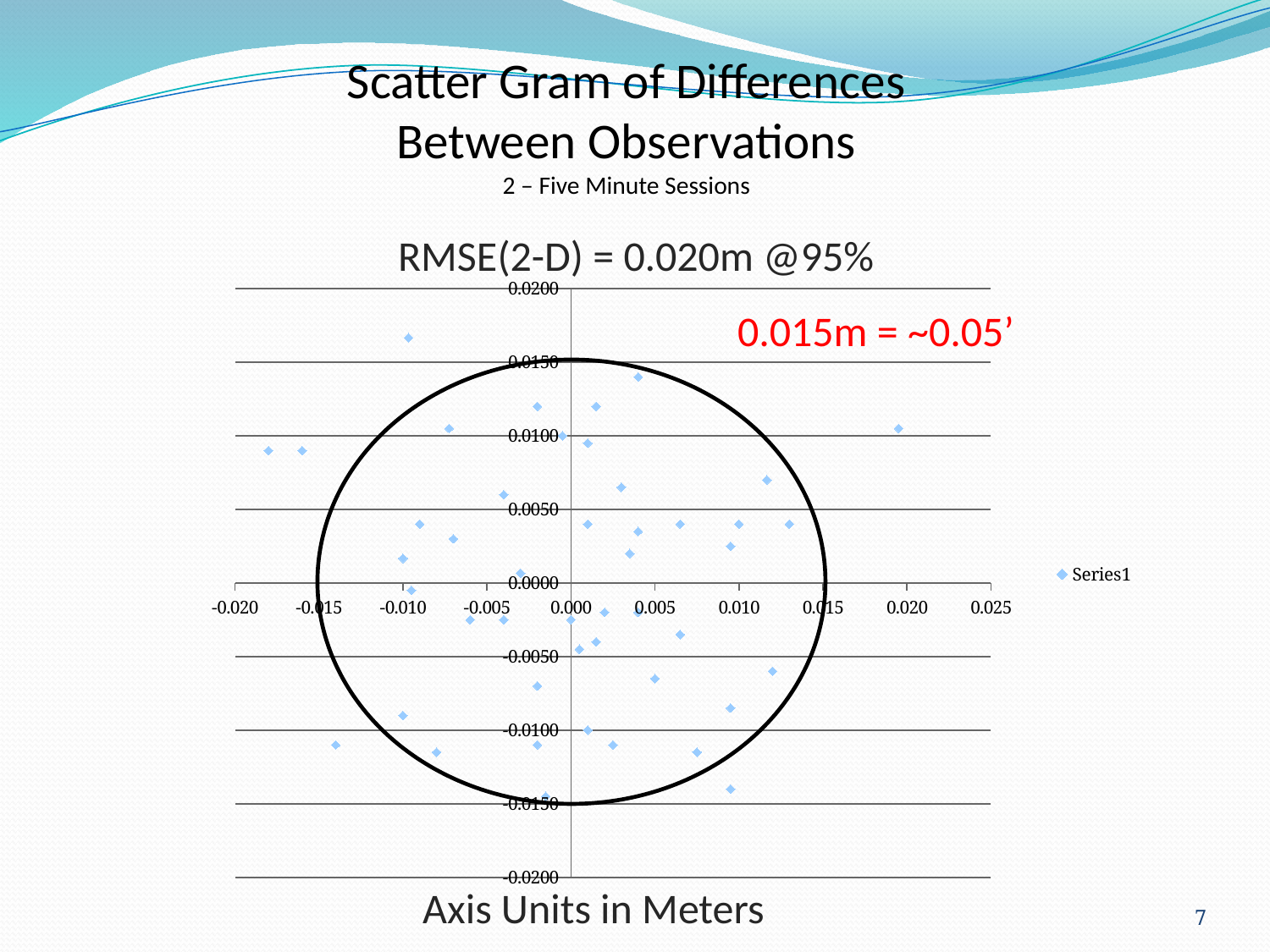
What is the title of the chart? RMSE(2-D) = 0.020m @95% Is the x value of the leftmost point in the chart greater or less than -0.020? greater Is the highest y value plotted in the chart greater or less than 0.0200? less Is the highest y value plotted in the chart greater or less than 0.0150? greater What is the name of the series shown in the chart legend? Series1 How many series does the chart legend list? 1 What kind of chart is shown on the slide? scatter chart